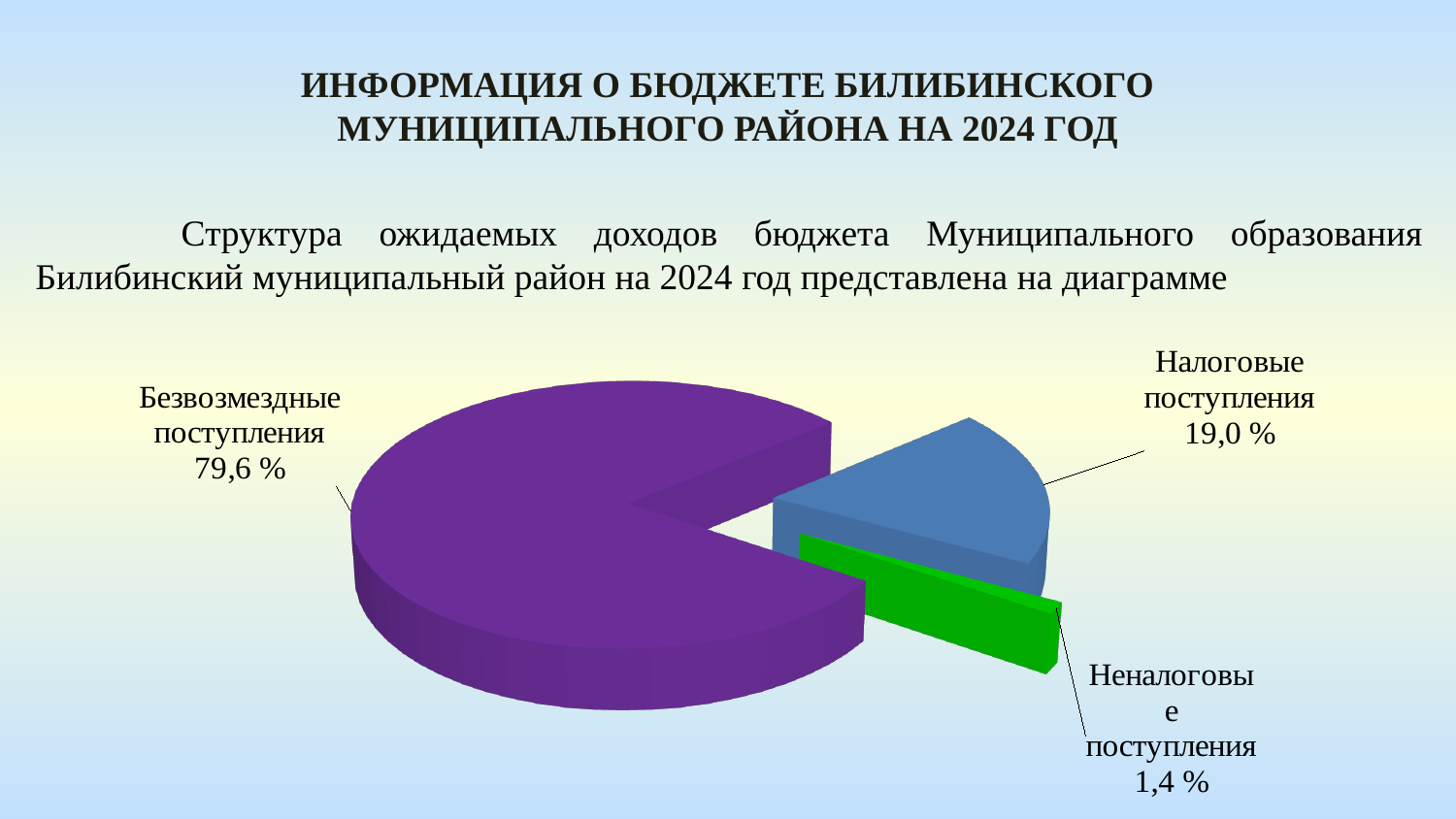
Which category has the smallest share of the pie? Неналоговые поступления Which category has the largest share of the pie? Безвозмездные поступления What share of the pie is Неналоговые поступления? 1,4 % What share of the pie is Безвозмездные поступления? 79,6 % What is the difference in percentage points between Налоговые поступления and Неналоговые поступления? 17,6 Which is larger: Налоговые поступления or Неналоговые поступления? Налоговые поступления What share of the pie is Налоговые поступления? 19,0 % What kind of chart is shown on the slide? pie chart How many slices does the pie chart have? 3 What colour is the slice for Неналоговые поступления? green What colour is the slice for Безвозмездные поступления? purple What is the difference in percentage points between Безвозмездные поступления and Налоговые поступления? 60,6